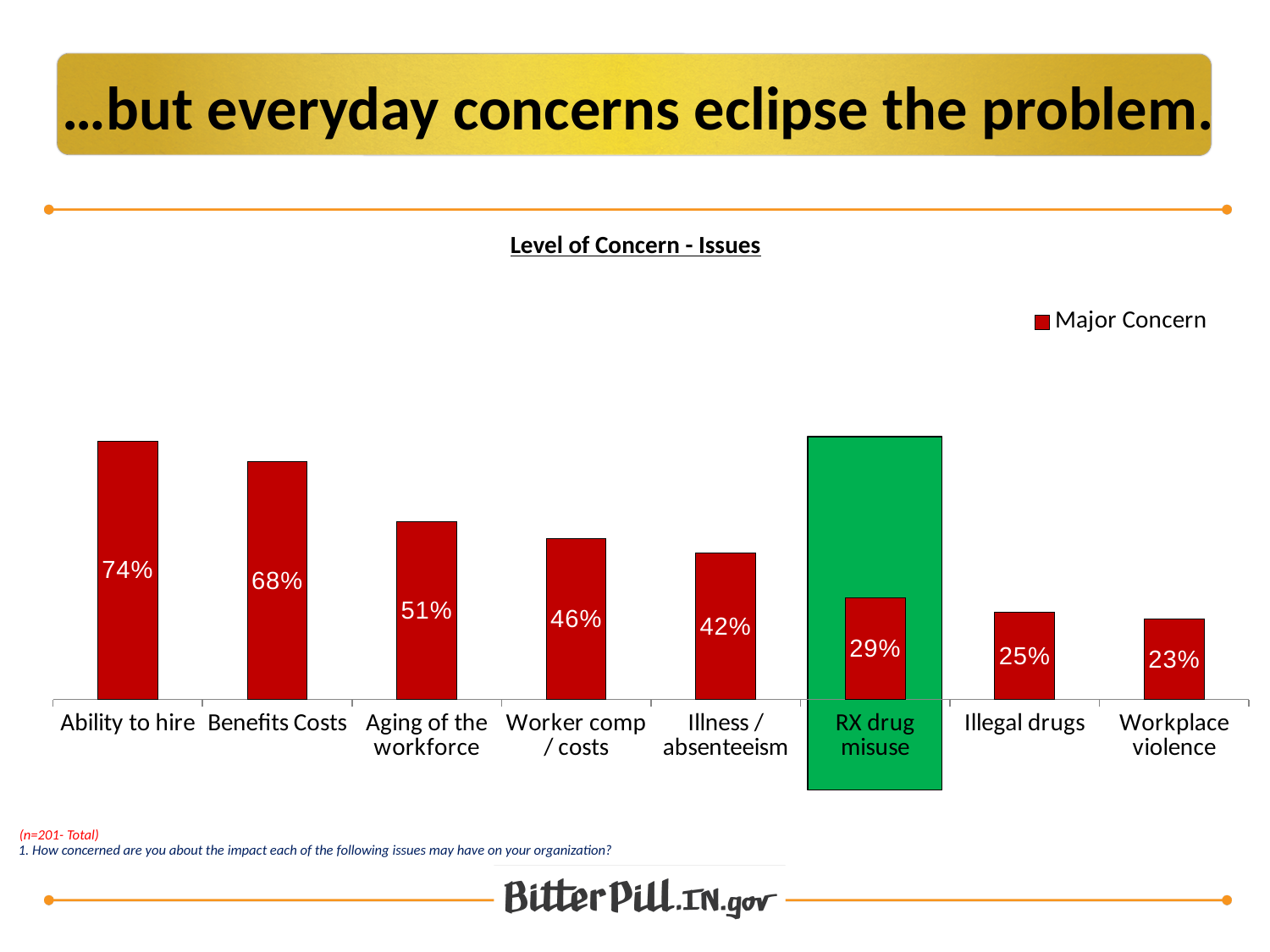
How many issues are shown on the chart? 8 What is the title of the chart? Level of Concern - Issues What is the value shown for 'RX drug misuse'? 29% What is the difference between the values for 'Benefits Costs' and 'RX drug misuse'? 39% What is the name of the series listed in the legend? Major Concern What type of chart is shown on the slide? Bar chart Which issue has the highest level of major concern? Ability to hire What percentage of respondents rated 'Ability to hire' as a major concern? 74% How many series does the legend list? 1 What is the value shown for 'Illness / absenteeism'? 42% Which has a higher value: 'Worker comp / costs' or 'Illegal drugs'? Worker comp / costs Which issue has the lowest level of major concern? Workplace violence